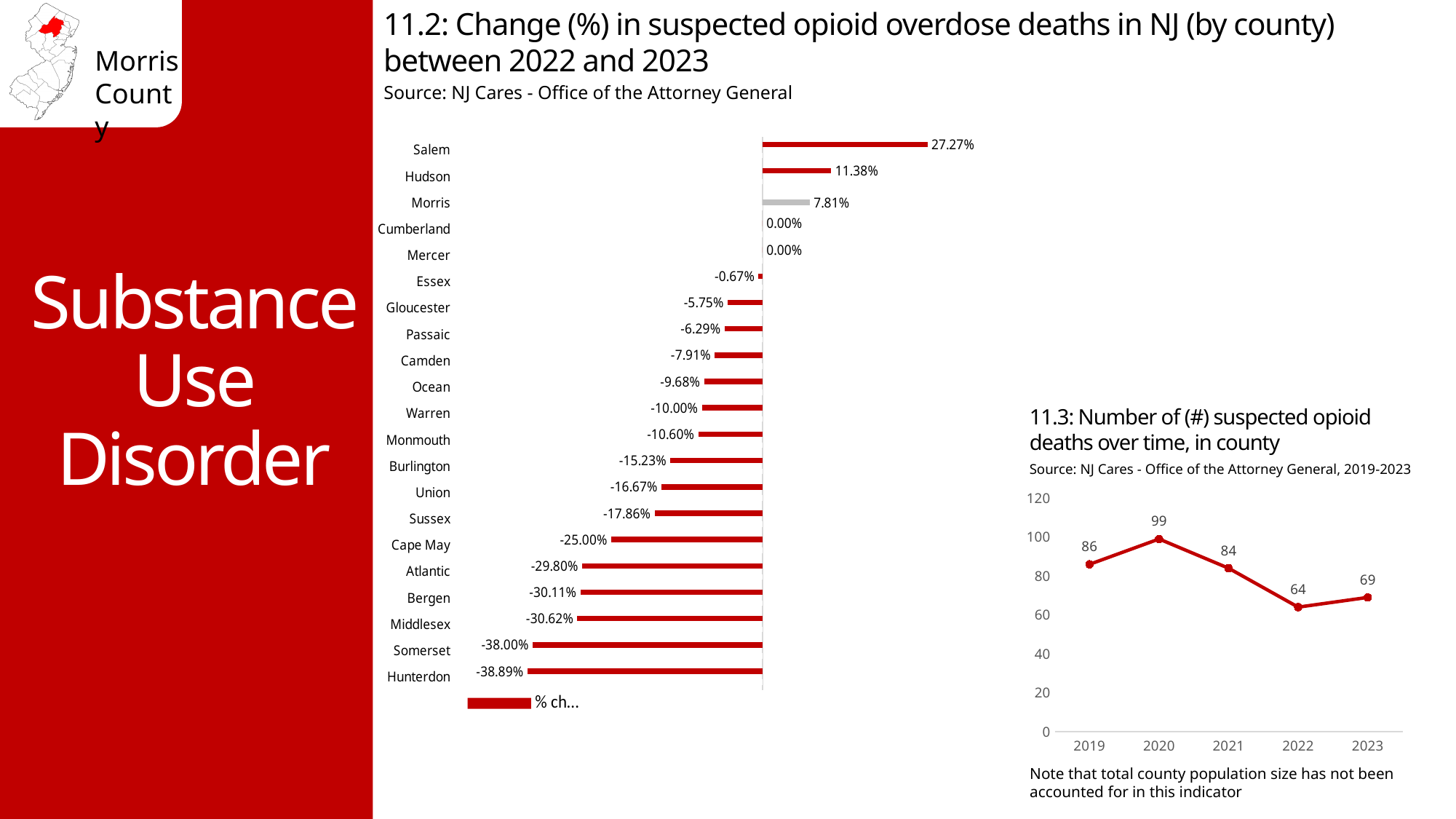
In the chart '11.2: Change (%) in suspected opioid overdose deaths in NJ (by county) between 2022 and 2023', how many counties are shown? 21 In the chart '11.2: Change (%) in suspected opioid overdose deaths in NJ (by county) between 2022 and 2023', which is larger, the value for Bergen or the value for Somerset? Bergen In the chart '11.3: Number of (#) suspected opioid deaths over time, in county', what kind of chart is it? Line chart In the chart '11.3: Number of (#) suspected opioid deaths over time, in county', how many data points are plotted? 5 In the chart '11.3: Number of (#) suspected opioid deaths over time, in county', what is the difference between the 2019 value and the 2023 value? 17 In the chart '11.2: Change (%) in suspected opioid overdose deaths in NJ (by county) between 2022 and 2023', what kind of chart is it? Bar chart In the chart '11.2: Change (%) in suspected opioid overdose deaths in NJ (by county) between 2022 and 2023', what is the value for Hudson? 11.38% In the chart '11.2: Change (%) in suspected opioid overdose deaths in NJ (by county) between 2022 and 2023', what is the value for Morris? 7.81% In the chart '11.3: Number of (#) suspected opioid deaths over time, in county', what is the value for 2020? 99 In the chart '11.2: Change (%) in suspected opioid overdose deaths in NJ (by county) between 2022 and 2023', which county has the lowest value? Hunterdon In the chart '11.3: Number of (#) suspected opioid deaths over time, in county', which year has the lowest value? 2022 In the chart '11.2: Change (%) in suspected opioid overdose deaths in NJ (by county) between 2022 and 2023', which county has the highest value? Salem